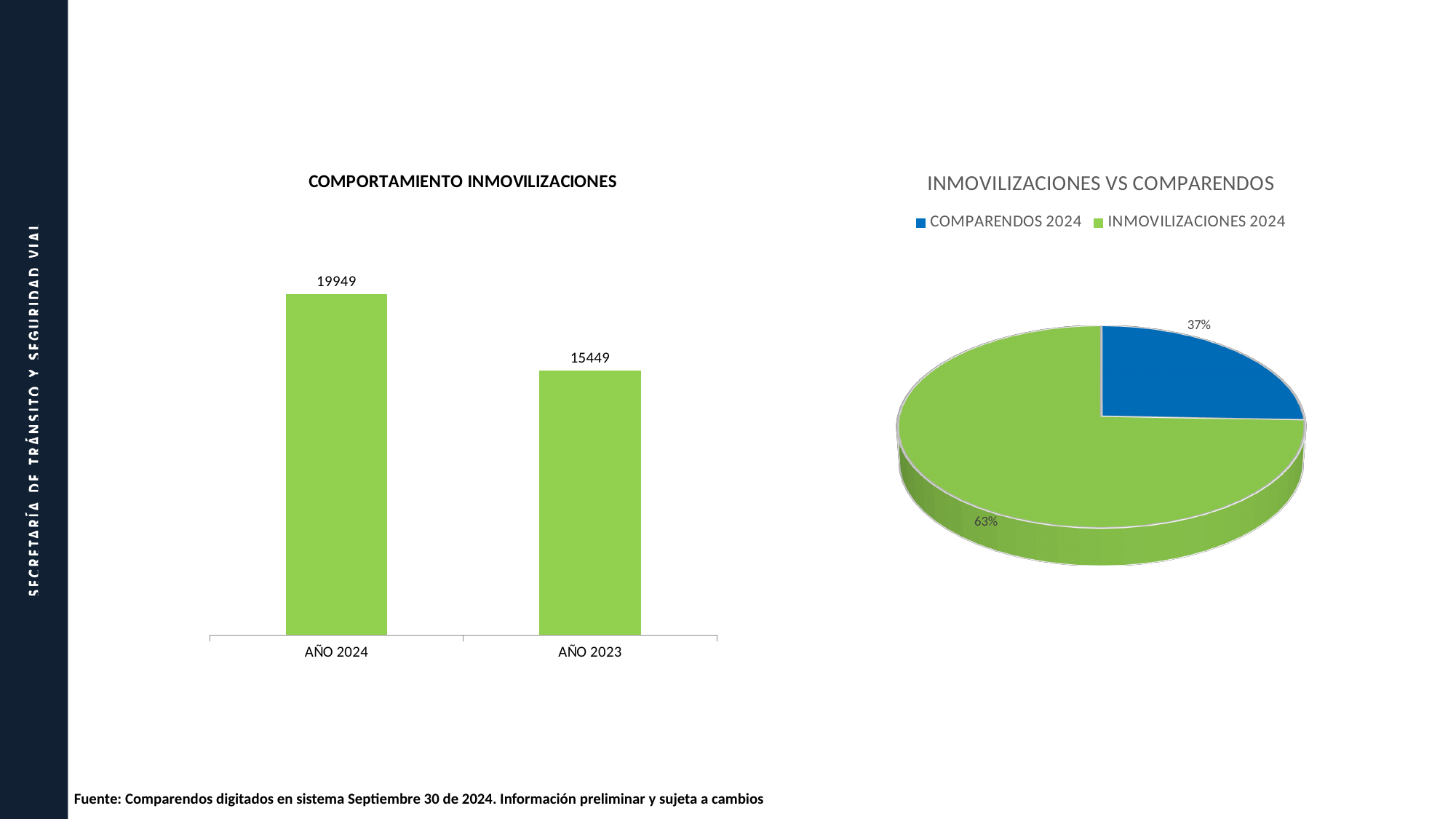
In the COMPORTAMIENTO INMOVILIZACIONES chart, how many categories are shown on the x axis? 2 In the INMOVILIZACIONES VS COMPARENDOS chart, what share does INMOVILIZACIONES 2024 have? 63% What kind of chart is COMPORTAMIENTO INMOVILIZACIONES? Bar chart In the COMPORTAMIENTO INMOVILIZACIONES chart, which year has the lower value? AÑO 2023 How many entries does the legend of the INMOVILIZACIONES VS COMPARENDOS chart list? 2 In the COMPORTAMIENTO INMOVILIZACIONES chart, which year has the higher value? AÑO 2024 In the COMPORTAMIENTO INMOVILIZACIONES chart, what is the value for AÑO 2023? 15449 In the COMPORTAMIENTO INMOVILIZACIONES chart, what is the difference between the AÑO 2024 and AÑO 2023 values? 4500 In the INMOVILIZACIONES VS COMPARENDOS chart, which slice is larger, COMPARENDOS 2024 or INMOVILIZACIONES 2024? INMOVILIZACIONES 2024 In the COMPORTAMIENTO INMOVILIZACIONES chart, what is the value for AÑO 2024? 19949 What kind of chart is INMOVILIZACIONES VS COMPARENDOS? Pie chart In the INMOVILIZACIONES VS COMPARENDOS chart, what share does COMPARENDOS 2024 have? 37%